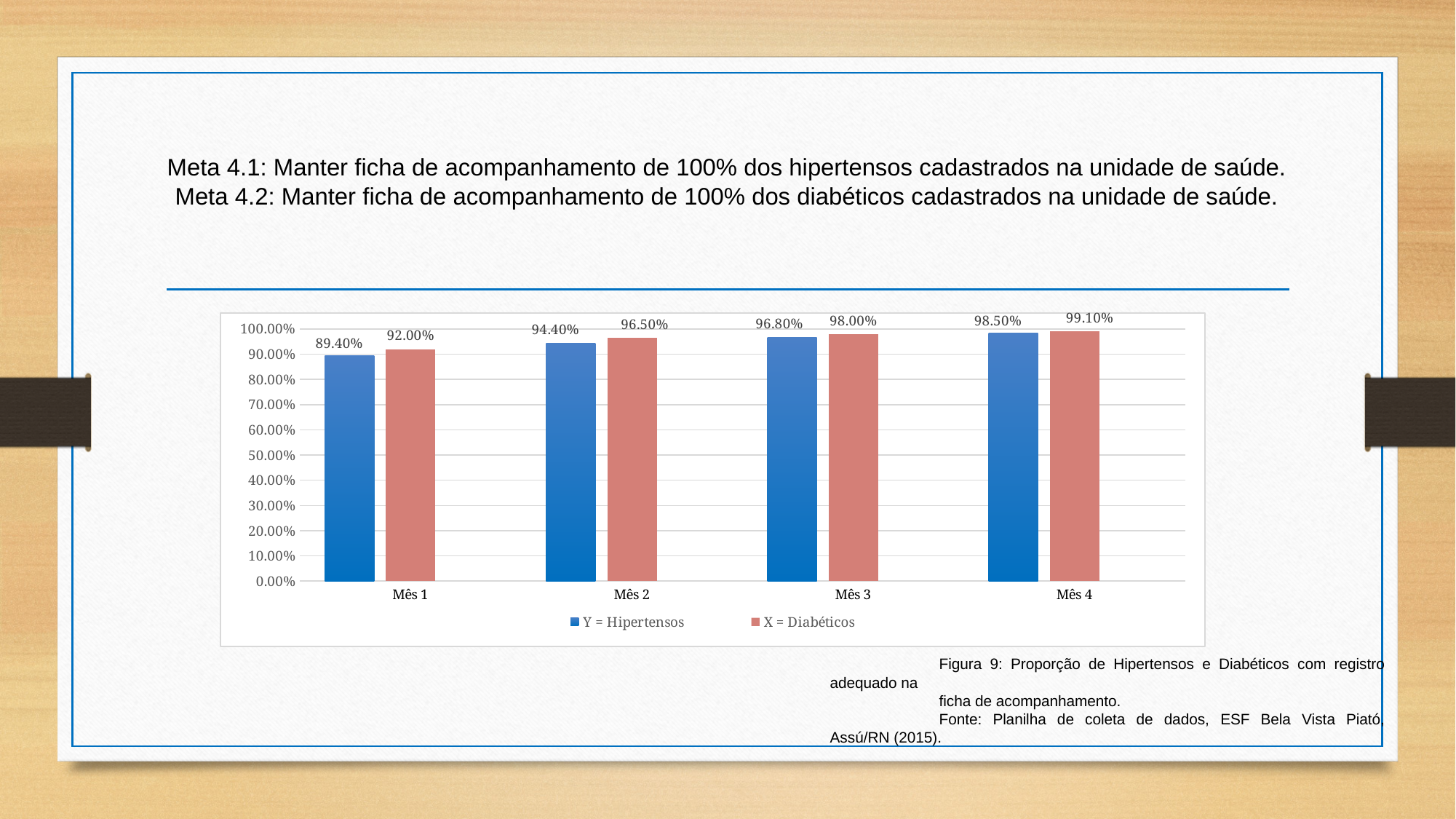
How many months are shown on the x axis? 4 Which colour represents the Diabéticos series? Red Do the Hipertensos values rise or fall from Mês 1 to Mês 4? Rise What is the value for Diabéticos in Mês 2? 96.50% How many series does the legend list? 2 In which month is the Diabéticos value lowest? Mês 1 What is the value for Diabéticos in Mês 4? 99.10% In which month is the Hipertensos value highest? Mês 4 Which is larger in Mês 3: Hipertensos or Diabéticos? Diabéticos What kind of chart is shown on the slide? Bar chart What is the difference between the Diabéticos and Hipertensos values in Mês 1? 2.60% What is the value for Hipertensos in Mês 1? 89.40%